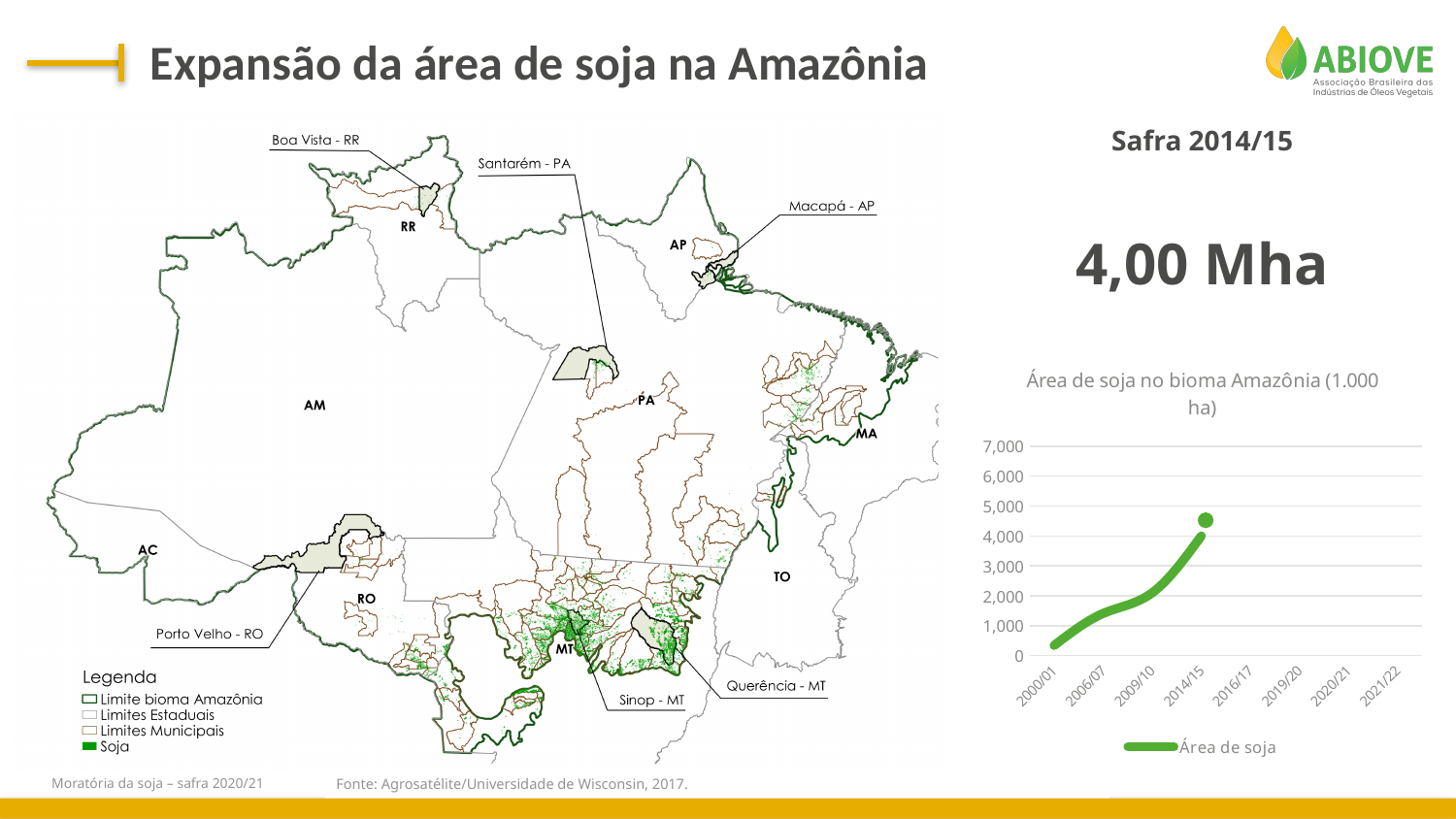
In the line chart, is the value for 2000/01 greater or less than 1,000? less In the line chart, which season has the lowest plotted value? 2000/01 What kind of chart is shown on the right side of the slide? line chart In the line chart, which is larger: the value for 2009/10 or the value for 2014/15? 2014/15 In the line chart, which season has the highest plotted value? 2014/15 How many series does the legend of the line chart list? 1 What is the title of the chart on the right side of the slide? Área de soja no bioma Amazônia (1.000 ha) What is the name of the series shown in the line chart's legend? Área de soja In the line chart, do the values rise or fall from 2000/01 to 2014/15? rise In the line chart, is the value for 2014/15 greater or less than 5,000? less How many season labels are shown on the x axis of the line chart? 8